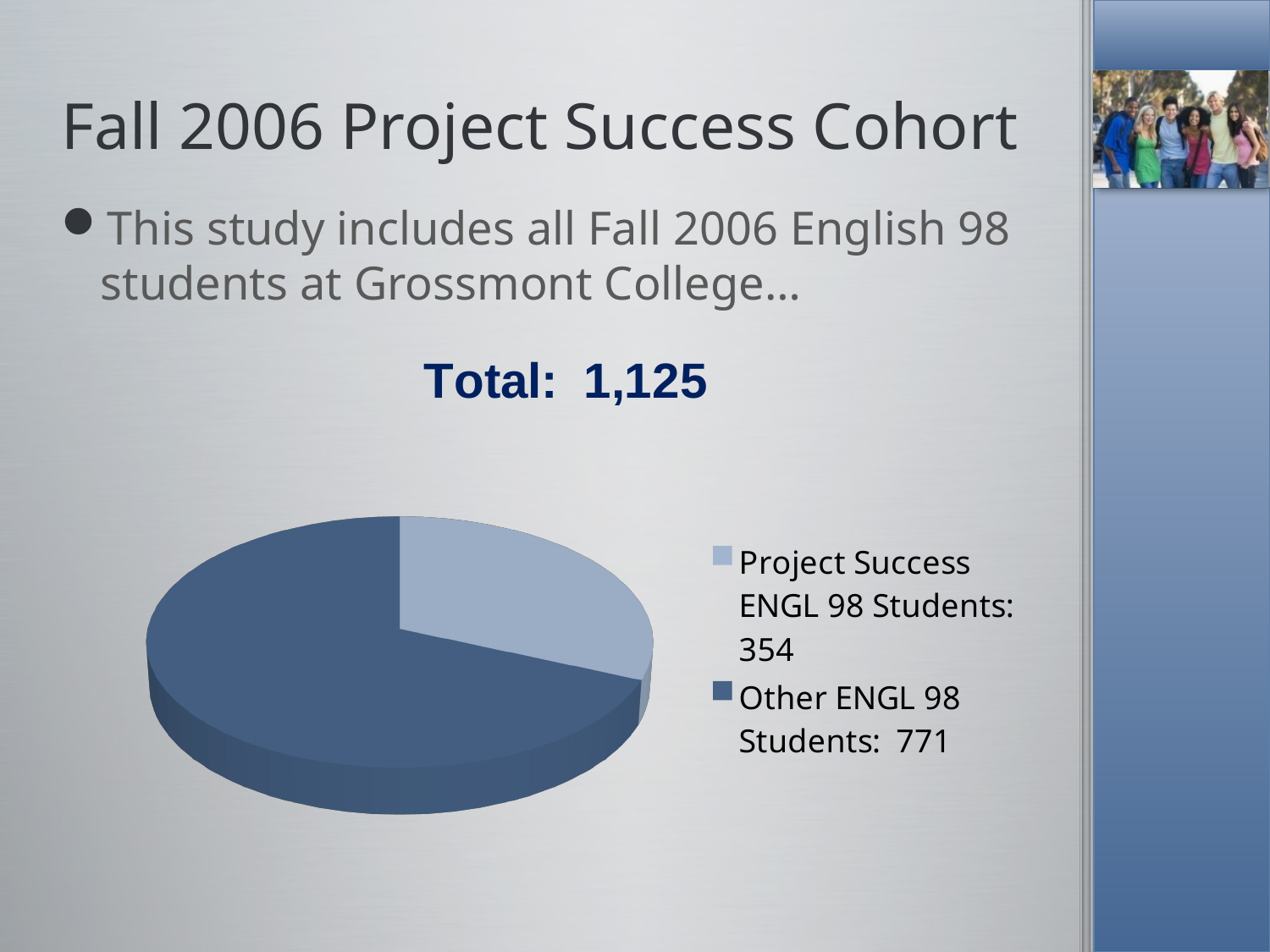
What is the title of the slide containing the pie chart? Fall 2006 Project Success Cohort How many Other ENGL 98 Students are shown in the legend? 771 How many slices does the pie chart have? 2 How many Project Success ENGL 98 Students are shown in the legend? 354 Is the value for Project Success ENGL 98 Students larger or smaller than the value for Other ENGL 98 Students? Smaller Which slice is shown in the lighter blue colour? Project Success ENGL 98 Students What total is printed above the pie chart? 1,125 Which category has the smaller slice of the pie? Project Success ENGL 98 Students Which category has the larger slice of the pie? Other ENGL 98 Students What is the difference between the number of Other ENGL 98 Students and Project Success ENGL 98 Students? 417 What kind of chart is shown on the slide? Pie chart How many entries does the legend list? 2